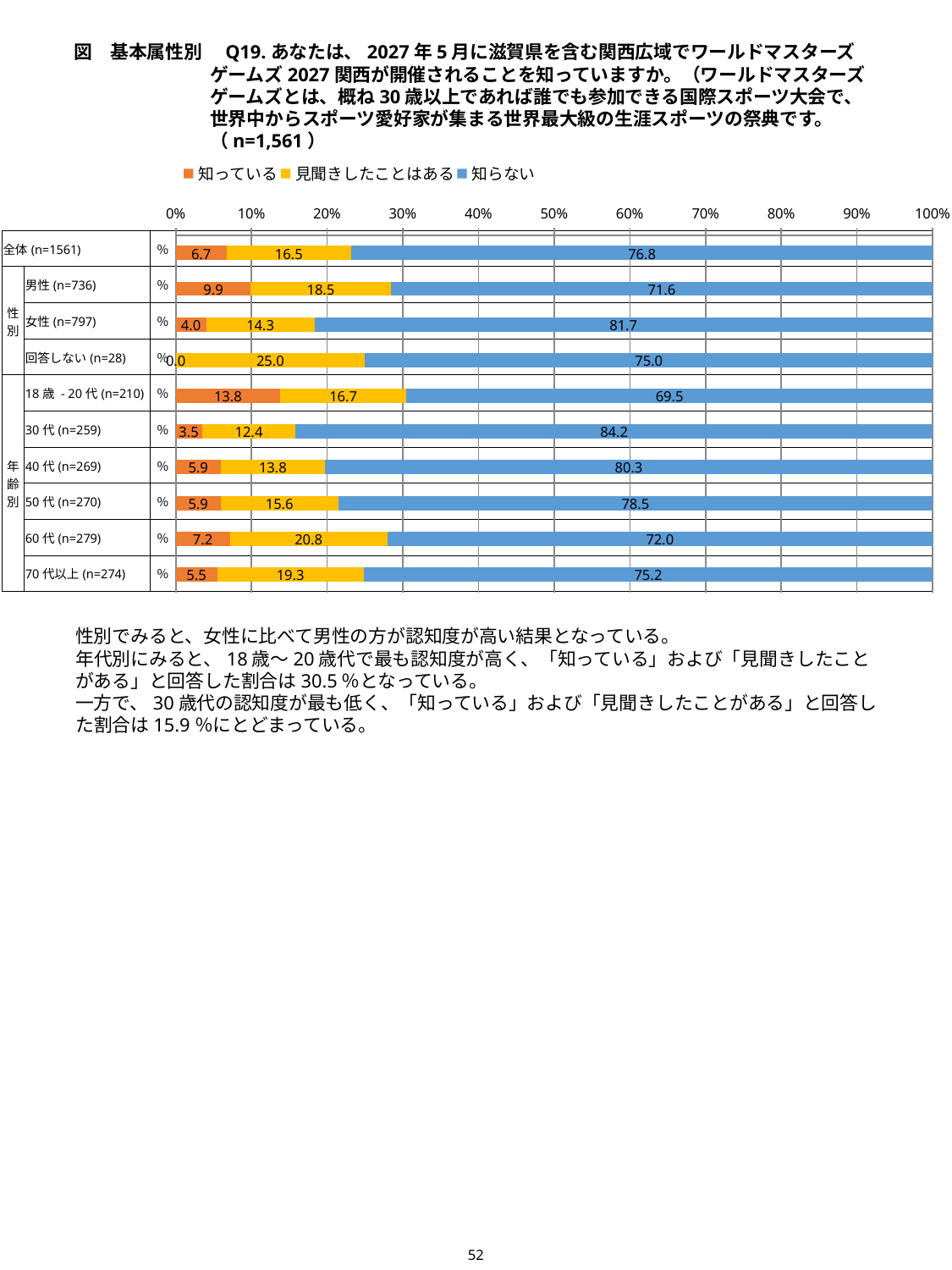
Which category has the lowest value for 「知っている」? 回答しない (n=28) What is the value of 「見聞きしたことはある」 for 60代 (n=279)? 20.8 Which category has the highest value for 「知っている」? 18歳 - 20代 (n=210) How many categories (rows) are plotted in the chart? 10 Which is larger, the 「見聞きしたことはある」 value for 70代以上 (n=274) or for 50代 (n=270)? 70代以上 (n=274) What is the combined value of 「知っている」 and 「見聞きしたことはある」 for 30代 (n=259)? 15.9 What is the difference between the 「知らない」 values for 女性 (n=797) and 男性 (n=736)? 10.1 What is the value of 「知っている」 for 男性 (n=736)? 9.9 What type of chart is shown on the slide? Stacked horizontal bar chart What is the value of 「知らない」 for 全体 (n=1561)? 76.8 Which category has the highest value for 「知らない」? 30代 (n=259) How many series does the legend list? 3